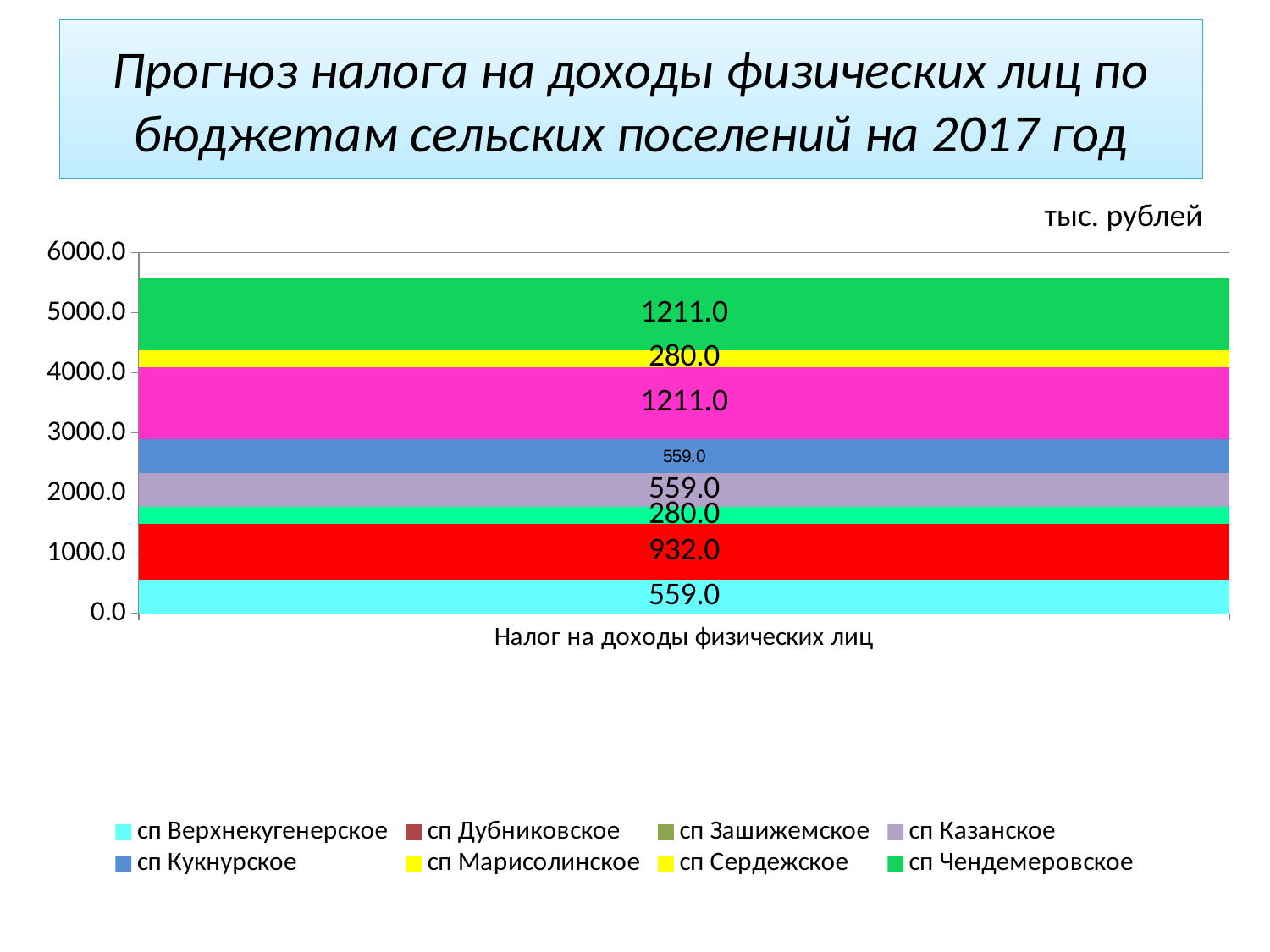
What is the value for сп Кукнурское? 559.0 What is the value for сп Дубниковское? 932.0 How many series does the legend list? 8 What kind of chart is shown on the slide? stacked bar chart What is the total of the stacked bar for Налог на доходы физических лиц? 5591.0 How many categories are plotted on the x axis? 1 What unit is stated above the chart? тыс. рублей What is the value for сп Верхнекугенерское? 559.0 What is the value for сп Чендемеровское? 1211.0 What is the value for сп Сердежское? 280.0 What is the difference between the values for сп Чендемеровское and сп Верхнекугенерское? 652.0 Which is larger, the value for сп Дубниковское or сп Сердежское? сп Дубниковское